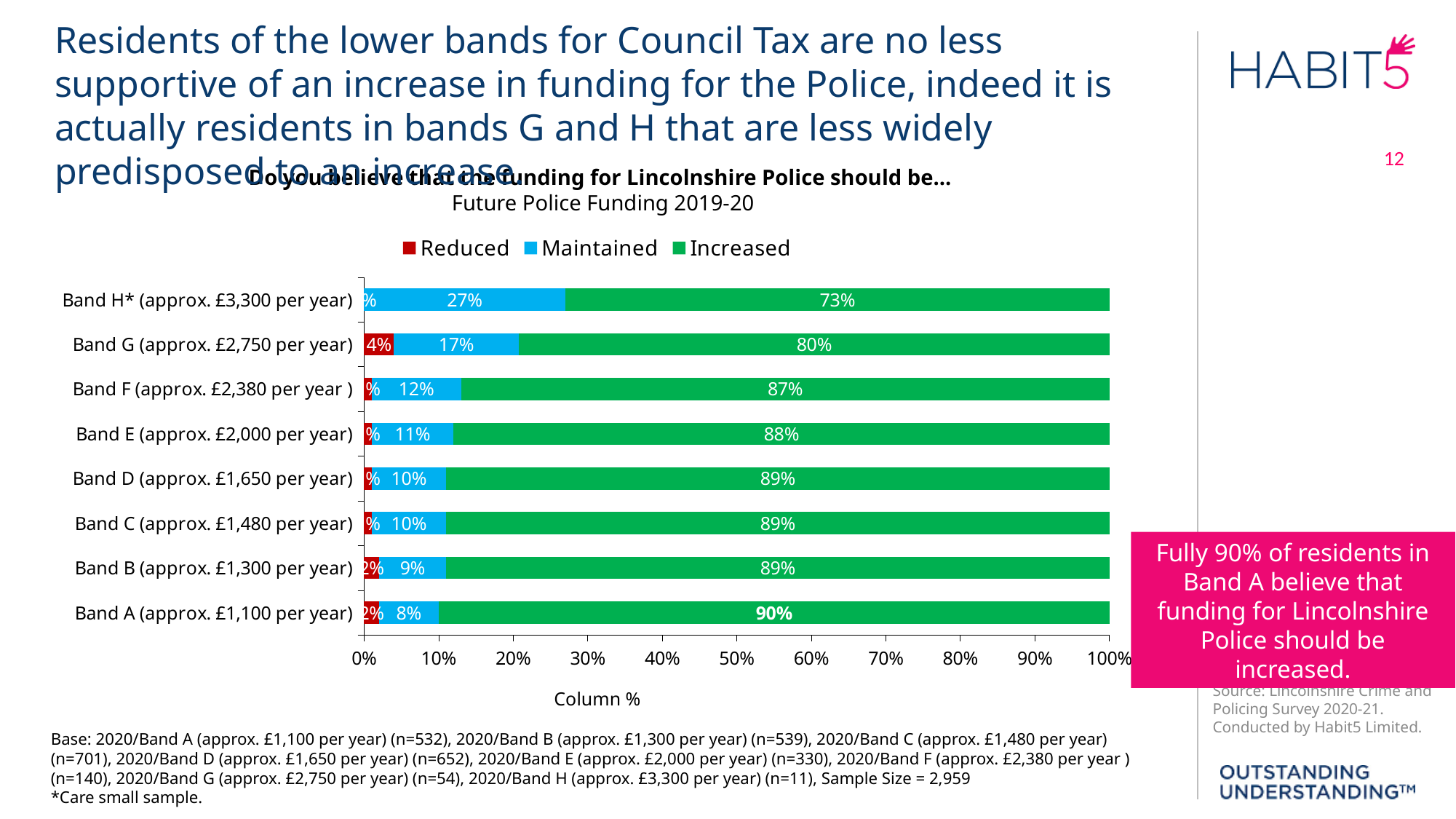
What is the 'Reduced' value for Band G (approx. £2,750 per year)? 4% What percentage of Band A residents believe funding for Lincolnshire Police should be increased? 90% Which band has the highest 'Maintained' percentage? Band H* (approx. £3,300 per year) What is the 'Maintained' value for Band H* (approx. £3,300 per year)? 27% What is the difference in percentage points between the 'Increased' values for Band A and Band H*? 17 percentage points How many series does the legend list? 3 What is the 'Increased' value for Band F (approx. £2,380 per year)? 87% How many council tax bands are shown on the chart? 8 What type of chart is shown on the slide? Stacked bar chart Which band has the highest 'Increased' percentage? Band A (approx. £1,100 per year) Which band has the lowest 'Increased' percentage? Band H* (approx. £3,300 per year) Which has a larger 'Increased' value: Band G or Band F? Band F (approx. £2,380 per year)